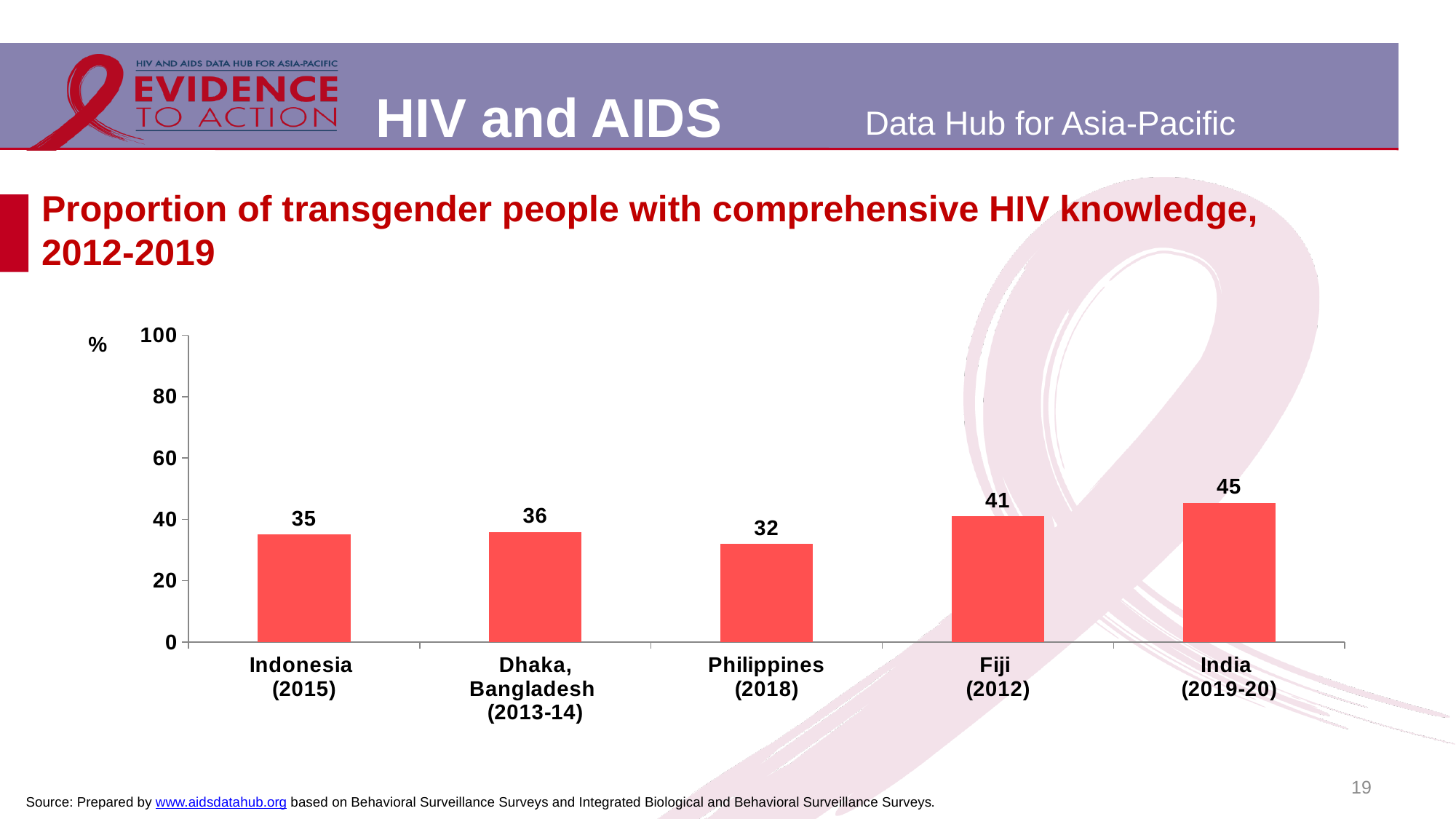
What is the value for Indonesia (2015)? 35 What kind of chart is shown on the slide? bar chart What is the difference between the values for India (2019-20) and Philippines (2018)? 13 What is the value for Philippines (2018)? 32 Is the value for Fiji (2012) greater or less than 60? less Which category has the highest value? India (2019-20) Which is larger, the value for Fiji (2012) or the value for Dhaka, Bangladesh (2013-14)? Fiji (2012) What is the difference between the values for Dhaka, Bangladesh (2013-14) and Indonesia (2015)? 1 How many categories are shown on the chart? 5 What is the value for India (2019-20)? 45 Which category has the lowest value? Philippines (2018) What unit is shown on the y axis of the chart? %